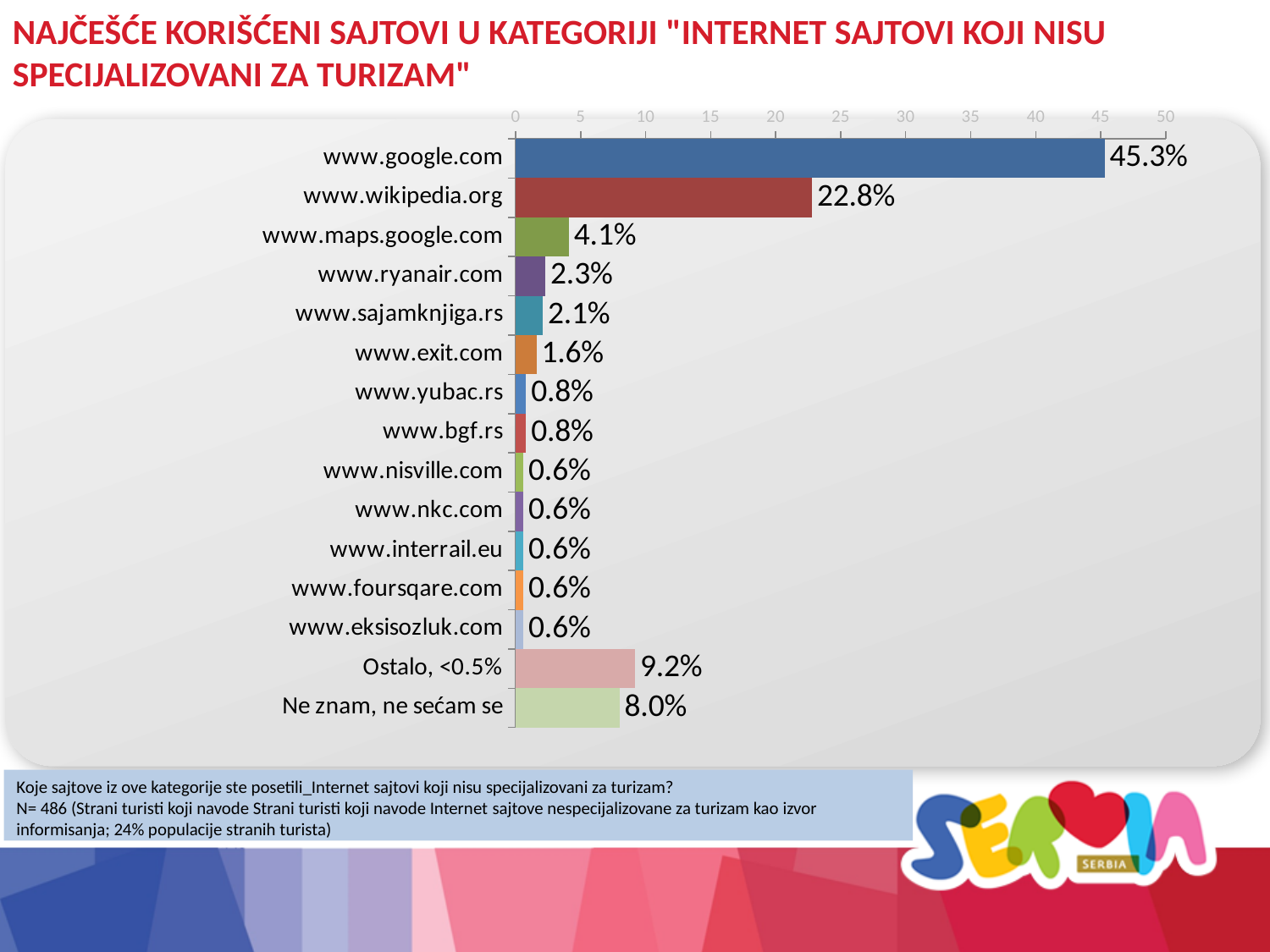
What is the value for www.wikipedia.org? 22.8% Which category has the highest value? www.google.com What is the value for www.google.com? 45.3% Is the value for www.wikipedia.org greater or less than 20? greater What is the value for www.sajamknjiga.rs? 2.1% What is the value for Ne znam, ne sećam se? 8.0% What kind of chart is shown on the slide? bar chart What is the value for www.maps.google.com? 4.1% What is the value for Ostalo, <0.5%? 9.2% Which is larger, the value for www.ryanair.com or the value for www.exit.com? www.ryanair.com How many categories are shown in the chart? 15 What is the difference between the values for www.google.com and www.wikipedia.org? 22.5%